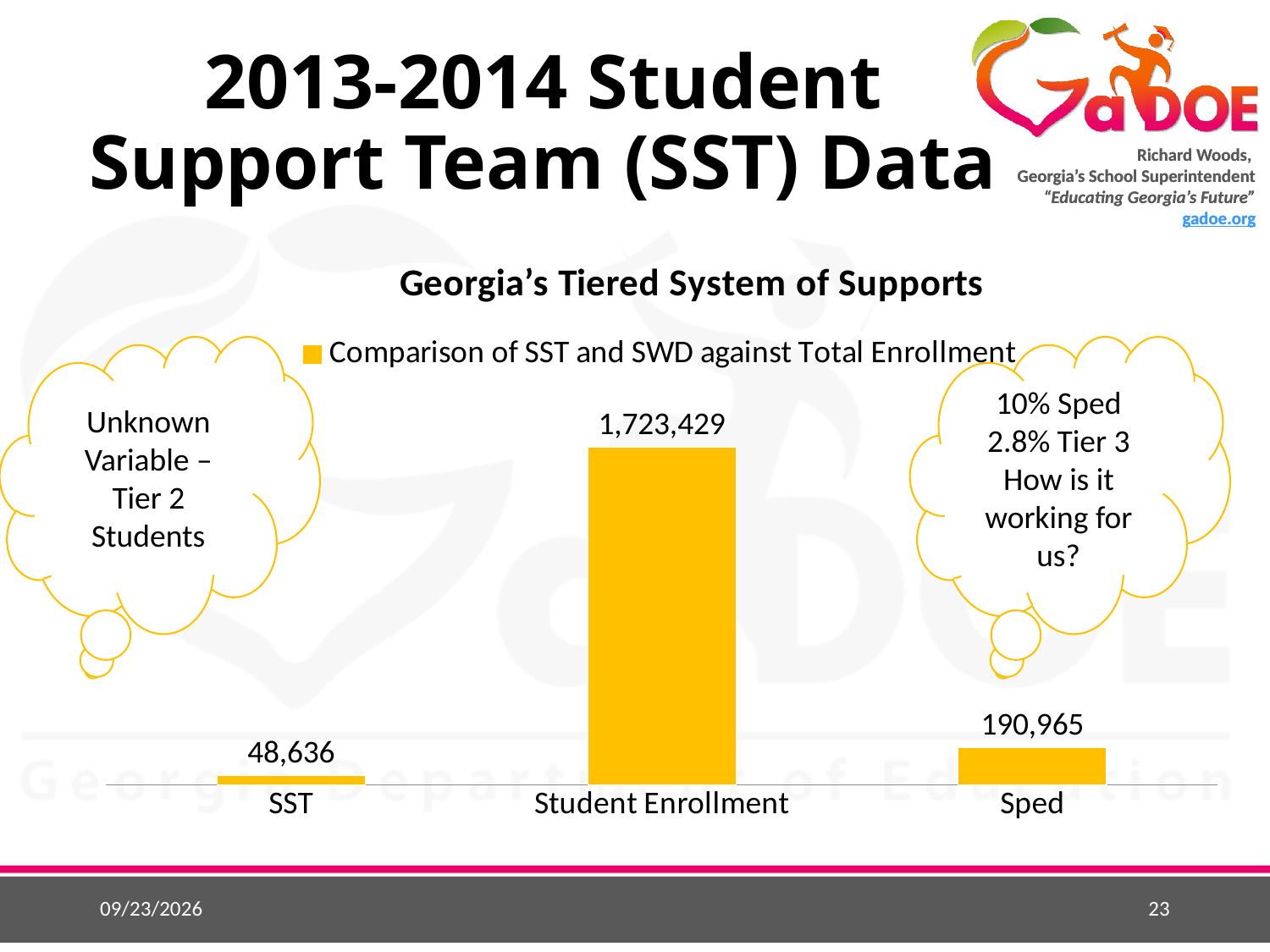
What is the title of the chart? Georgia's Tiered System of Supports Which category has the lowest value? SST What kind of chart is shown? Bar chart Which category has the highest value? Student Enrollment How many categories are shown on the x axis? 3 What is the value for Student Enrollment? 1,723,429 How many series does the legend list? 1 What is the difference between the Student Enrollment value and the Sped value? 1,532,464 Which is larger, the value for Sped or the value for SST? Sped What is the value for Sped? 190,965 What is the value for SST? 48,636 What is the difference between the Sped value and the SST value? 142,329